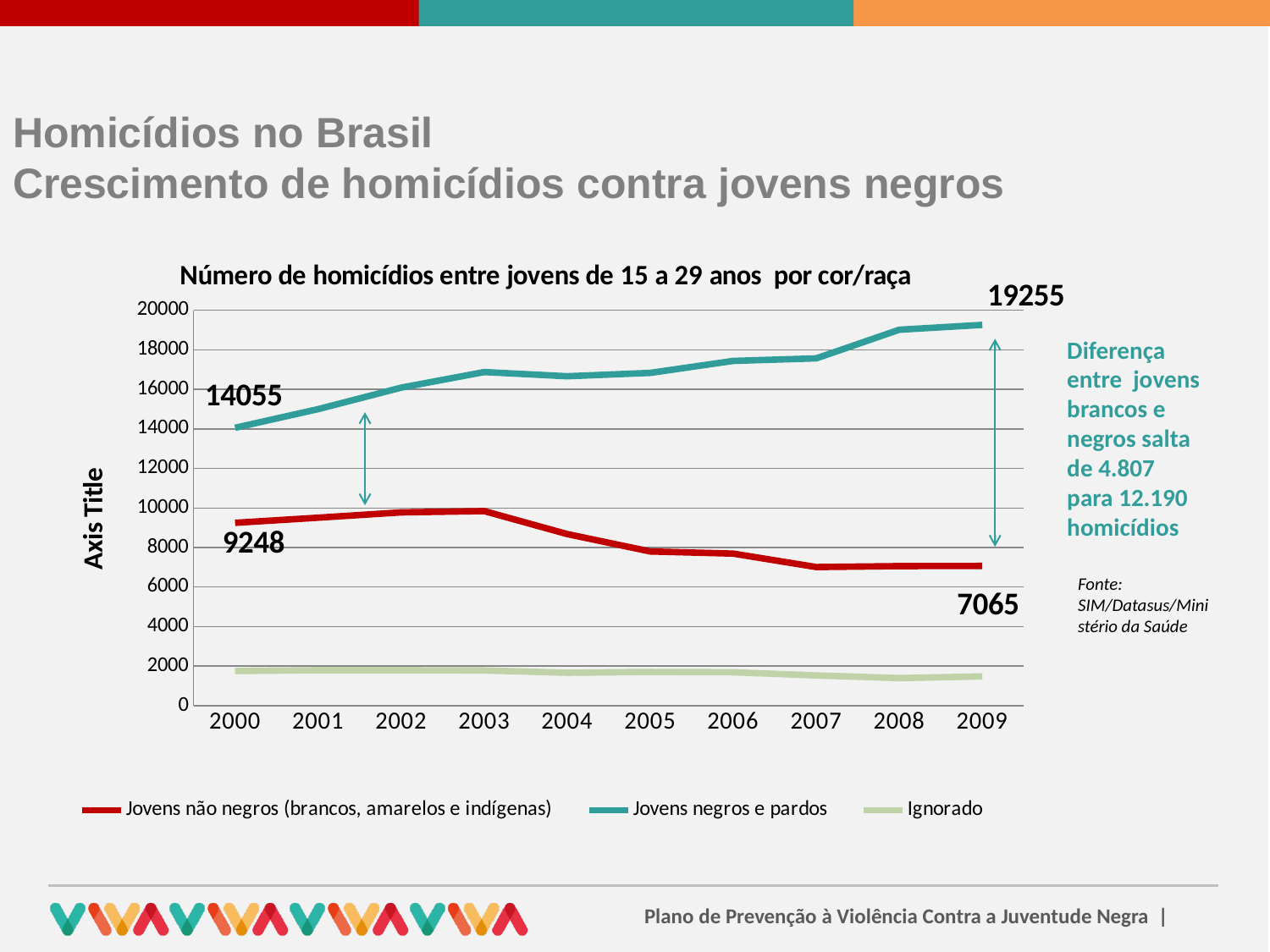
What is the value for Jovens não negros (brancos, amarelos e indígenas) in 2000? 9248 Which series has the highest value in 2009? Jovens negros e pardos How many series does the legend list? 3 Is the value for Ignorado in 2005 greater or less than 4000? less What is the difference between Jovens negros e pardos and Jovens não negros in 2009? 12190 What is the title of the chart? Número de homicídios entre jovens de 15 a 29 anos por cor/raça How many years are shown on the x axis? 10 What type of chart is shown on the slide? line chart What is the value for Jovens negros e pardos in 2000? 14055 What is the value for Jovens não negros (brancos, amarelos e indígenas) in 2009? 7065 Does the Jovens negros e pardos series rise or fall from 2000 to 2009? rise What is the value for Jovens negros e pardos in 2009? 19255